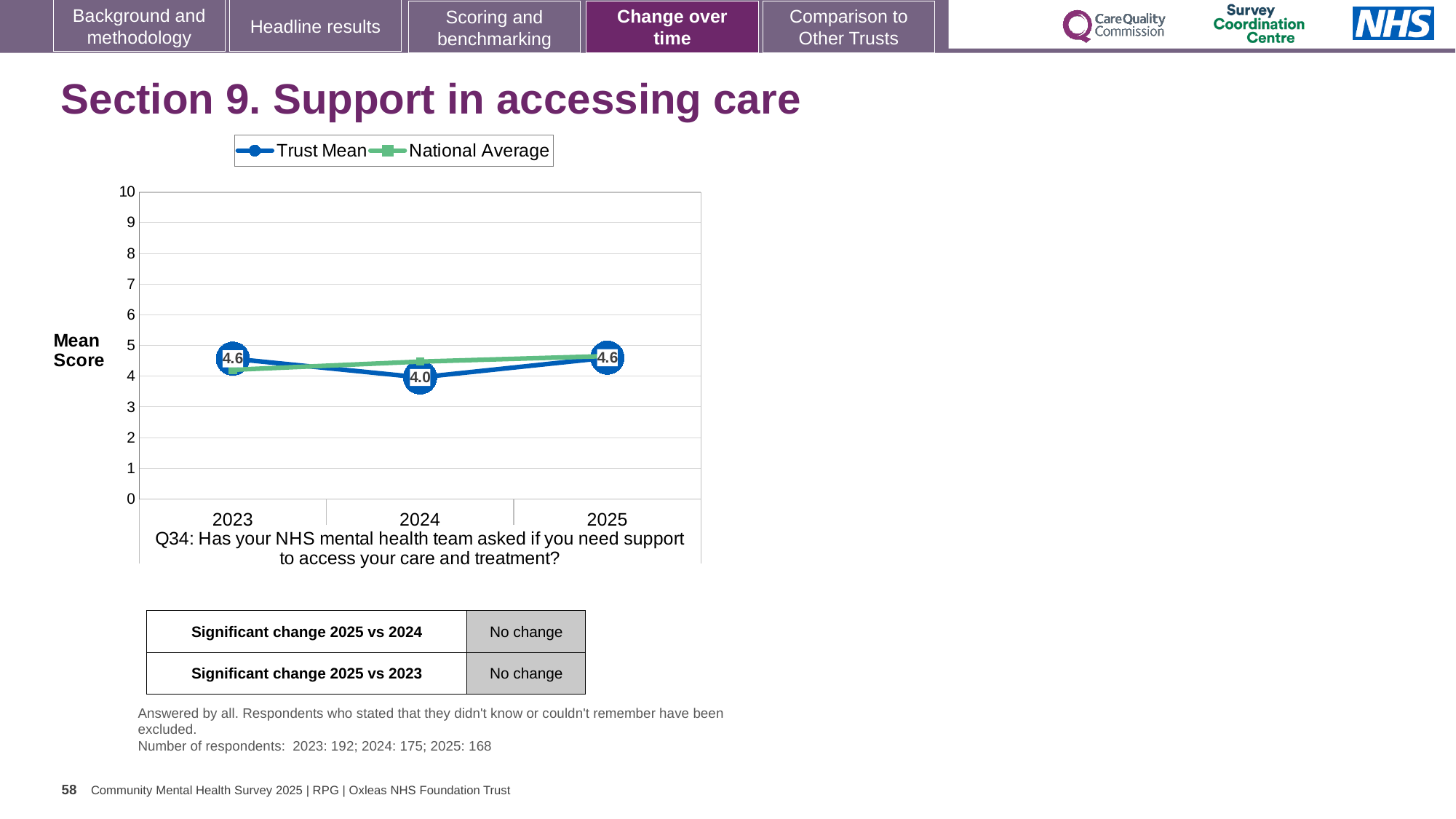
What is the Trust Mean score for 2025? 4.6 What is the difference between the Trust Mean scores for 2023 and 2024? 0.6 Is the Trust Mean value for 2024 greater or less than 3? greater How many series does the chart legend list? 2 Which year has the larger Trust Mean score, 2023 or 2024? 2023 In which year is the Trust Mean score lowest? 2024 Is the National Average value for 2024 greater or less than 5? less Does the Trust Mean score rise or fall from 2024 to 2025? rise How many years are plotted on the x axis of the chart? 3 What is the Trust Mean score for 2024? 4.0 What is the Trust Mean score for 2023? 4.6 What kind of chart is shown on the slide? line chart